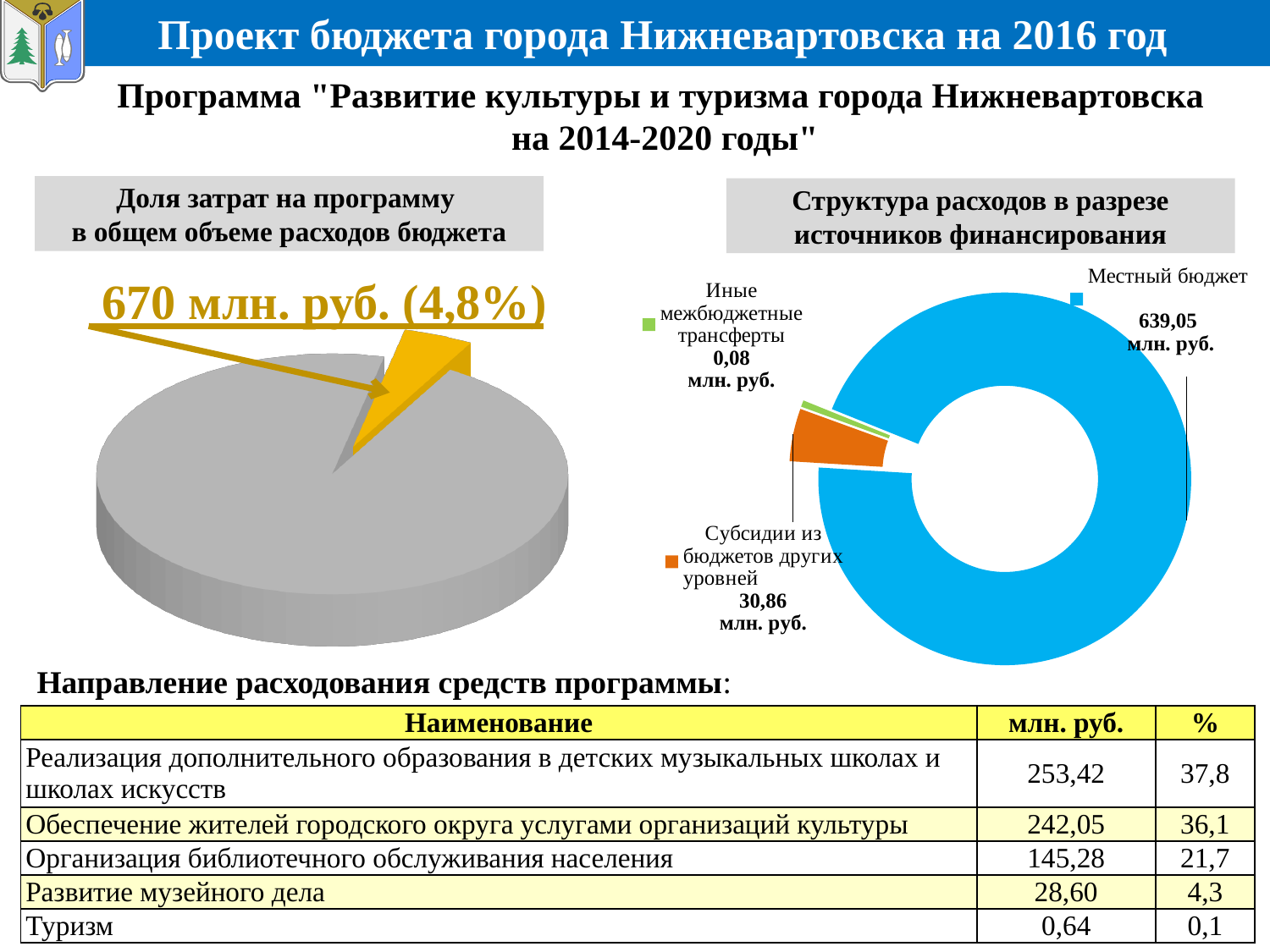
On the right chart "Структура расходов в разрезе источников финансирования", which is larger: Субсидии из бюджетов других уровней or Иные межбюджетные трансферты? Субсидии из бюджетов других уровней What kind of chart is the left chart "Доля затрат на программу в общем объеме расходов бюджета"? pie chart On the right chart "Структура расходов в разрезе источников финансирования", what is the value for Иные межбюджетные трансферты? 0,08 млн. руб. What kind of chart is the right chart "Структура расходов в разрезе источников финансирования"? doughnut chart On the right chart "Структура расходов в разрезе источников финансирования", which funding source has the largest value? Местный бюджет On the right chart "Структура расходов в разрезе источников финансирования", what is the value for Местный бюджет? 639,05 млн. руб. How many funding sources are shown on the right chart "Структура расходов в разрезе источников финансирования"? 3 On the right chart "Структура расходов в разрезе источников финансирования", which funding source has the smallest value? Иные межбюджетные трансферты On the right chart "Структура расходов в разрезе источников финансирования", how much larger is Местный бюджет than Субсидии из бюджетов других уровней? 608,19 млн. руб. On the right chart "Структура расходов в разрезе источников финансирования", what is the value for Субсидии из бюджетов других уровней? 30,86 млн. руб. On the left chart "Доля затрат на программу в общем объеме расходов бюджета", what value is shown for the highlighted slice? 670 млн. руб. (4,8%) On the left chart "Доля затрат на программу в общем объеме расходов бюджета", what share of the total budget expenditure does the programme represent? 4,8%